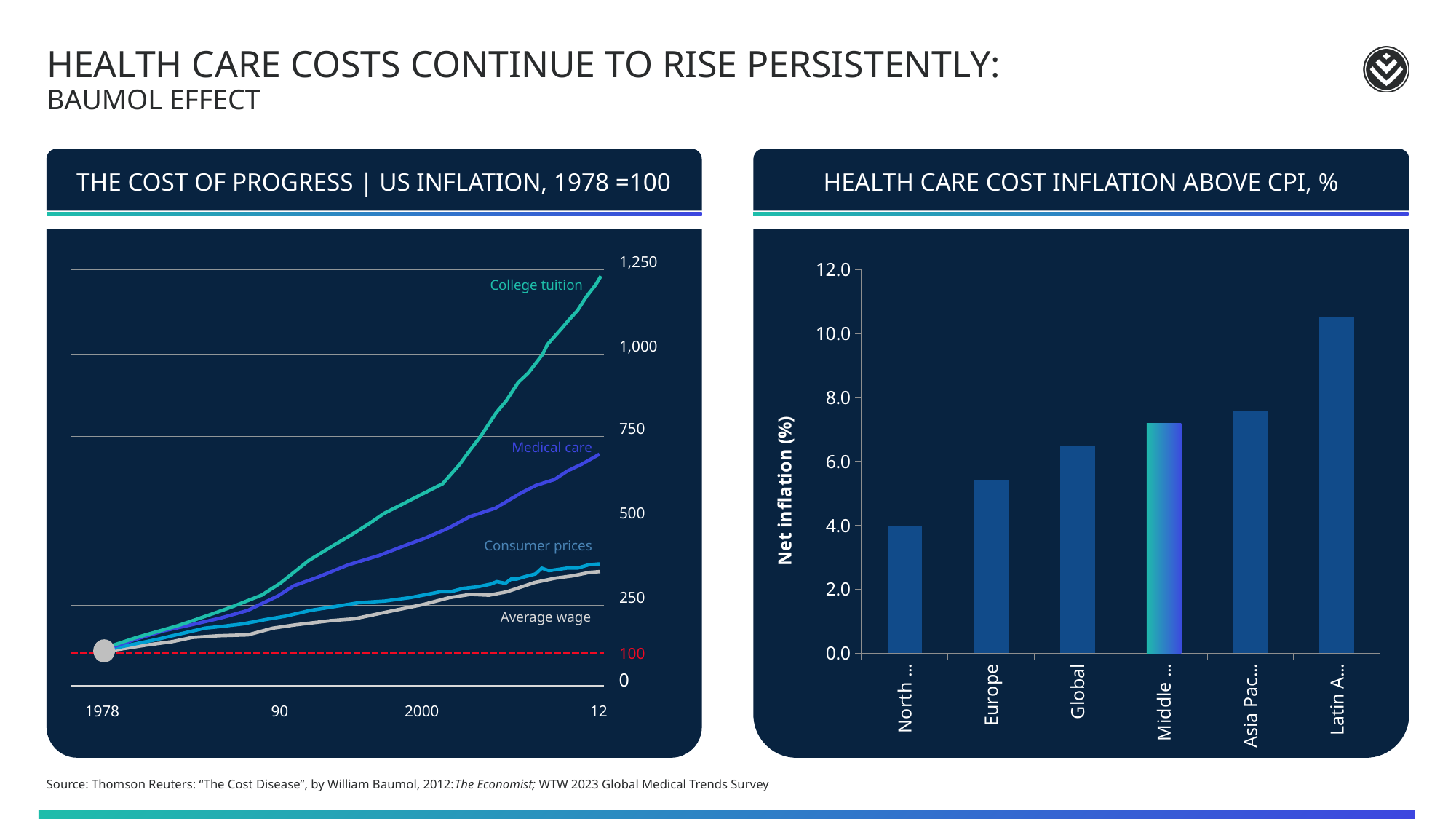
What kind of chart is the left-hand chart, 'The cost of progress | US inflation, 1978 =100'? line chart In the right-hand chart 'Health care cost inflation above CPI, %', which is larger, Europe or Global? Global In the left-hand chart 'The cost of progress', does the College tuition line rise or fall from 1978 to 2012? rises What kind of chart is the right-hand chart, 'Health care cost inflation above CPI, %'? bar chart In the left-hand chart 'The cost of progress', is the Medical care value in 2012 greater or less than 750? less In the right-hand chart 'Health care cost inflation above CPI, %', is the value for Europe greater or less than 6.0? less In the left-hand chart 'The cost of progress', which series is highest at the end of the period (2012)? College tuition In the left-hand chart 'The cost of progress', is the College tuition value in 2012 greater or less than 1,000? greater In the left-hand chart 'The cost of progress', how many series are plotted? 4 In the right-hand chart 'Health care cost inflation above CPI, %', how many bars are shown? 6 In the left-hand chart 'The cost of progress', which series is lowest at the end of the period (2012)? Average wage In the right-hand chart 'Health care cost inflation above CPI, %', what is the label on the vertical axis? Net inflation (%)